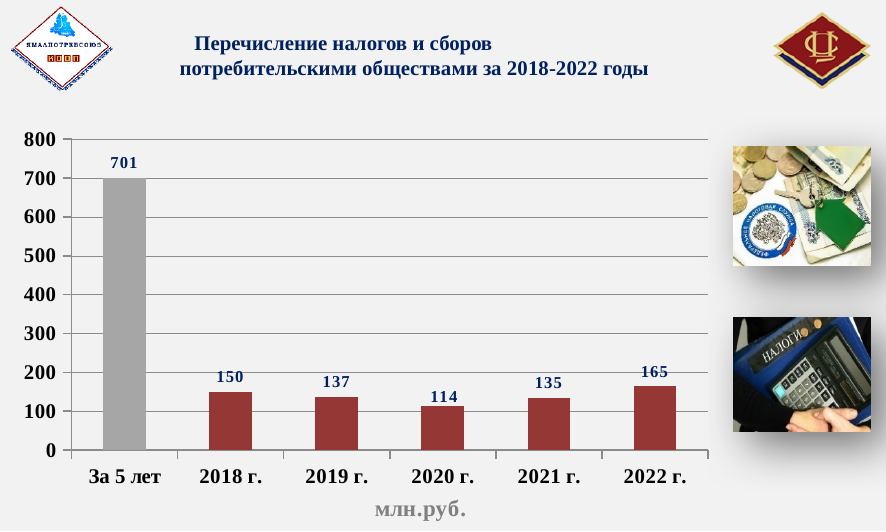
What value is shown for 2018 г.? 150 How many bars are plotted on the chart? 6 Do the values rise or fall from 2020 г. to 2022 г.? rise Which is larger, the value for 2019 г. or the value for 2021 г.? 2019 г. Which category has the lowest value on the chart? 2020 г. Is the value for 2022 г. greater or less than 200? less What value is shown for the bar labelled 'За 5 лет'? 701 Among the individual years 2018 г. to 2022 г., which year has the highest value? 2022 г. What is the difference between the values for 2022 г. and 2021 г.? 30 What value is shown for 2020 г.? 114 What kind of chart is shown on the slide? bar chart What unit is indicated below the x axis of the chart? млн.руб.